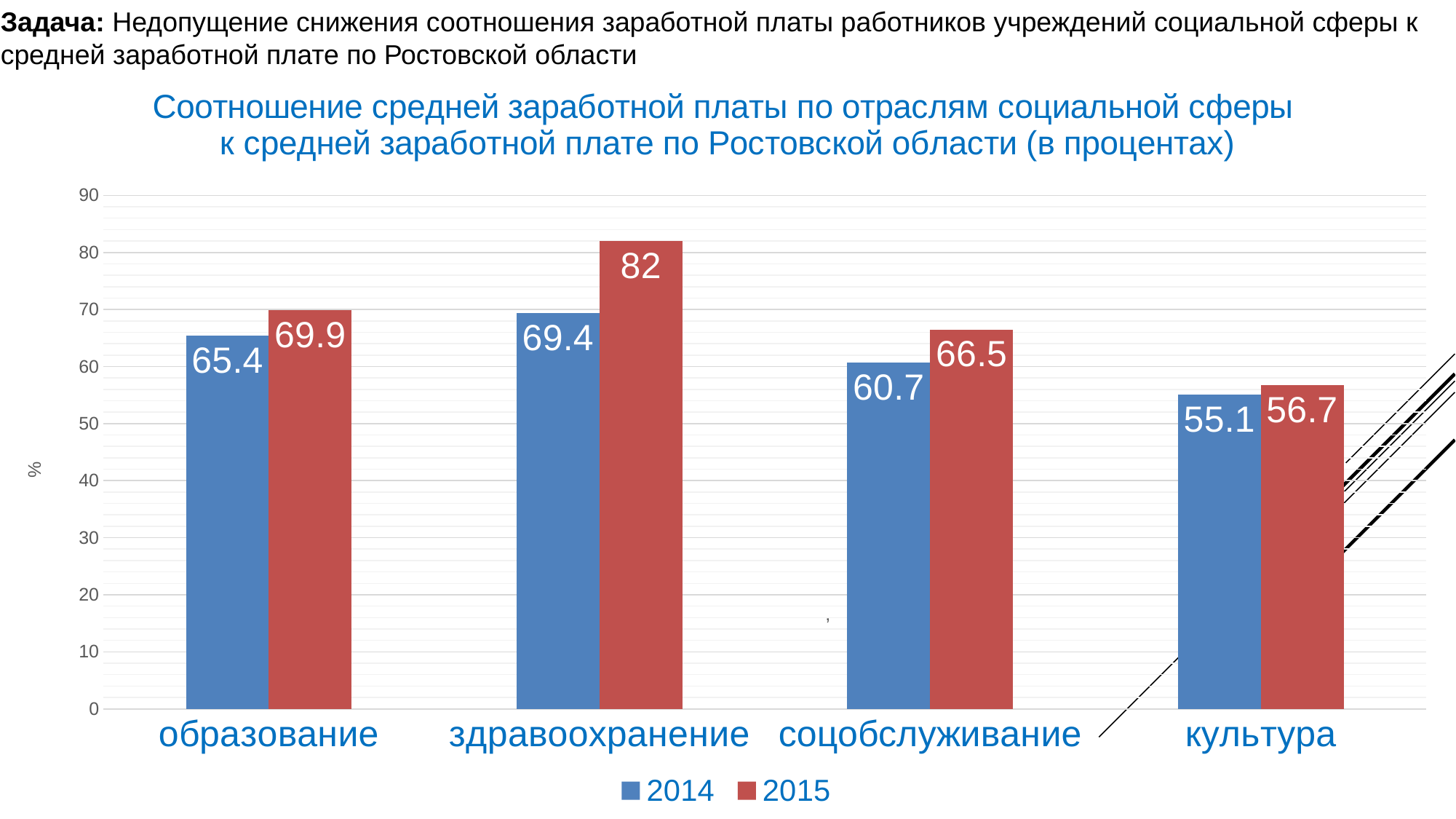
How many categories are shown on the x axis? 4 Which category has the highest 2015 value? здравоохранение What kind of chart is shown on the slide? bar chart What is the 2015 value for соцобслуживание? 66.5 What is the 2015 value for здравоохранение? 82 Which colour represents the 2015 series? red What is the difference between the 2015 and 2014 values for здравоохранение? 12.6 Which category has the lowest 2014 value? культура How many series does the legend list? 2 What is the 2014 value for образование? 65.4 What is the 2014 value for культура? 55.1 Which is larger: the 2014 value for образование or the 2014 value for соцобслуживание? образование